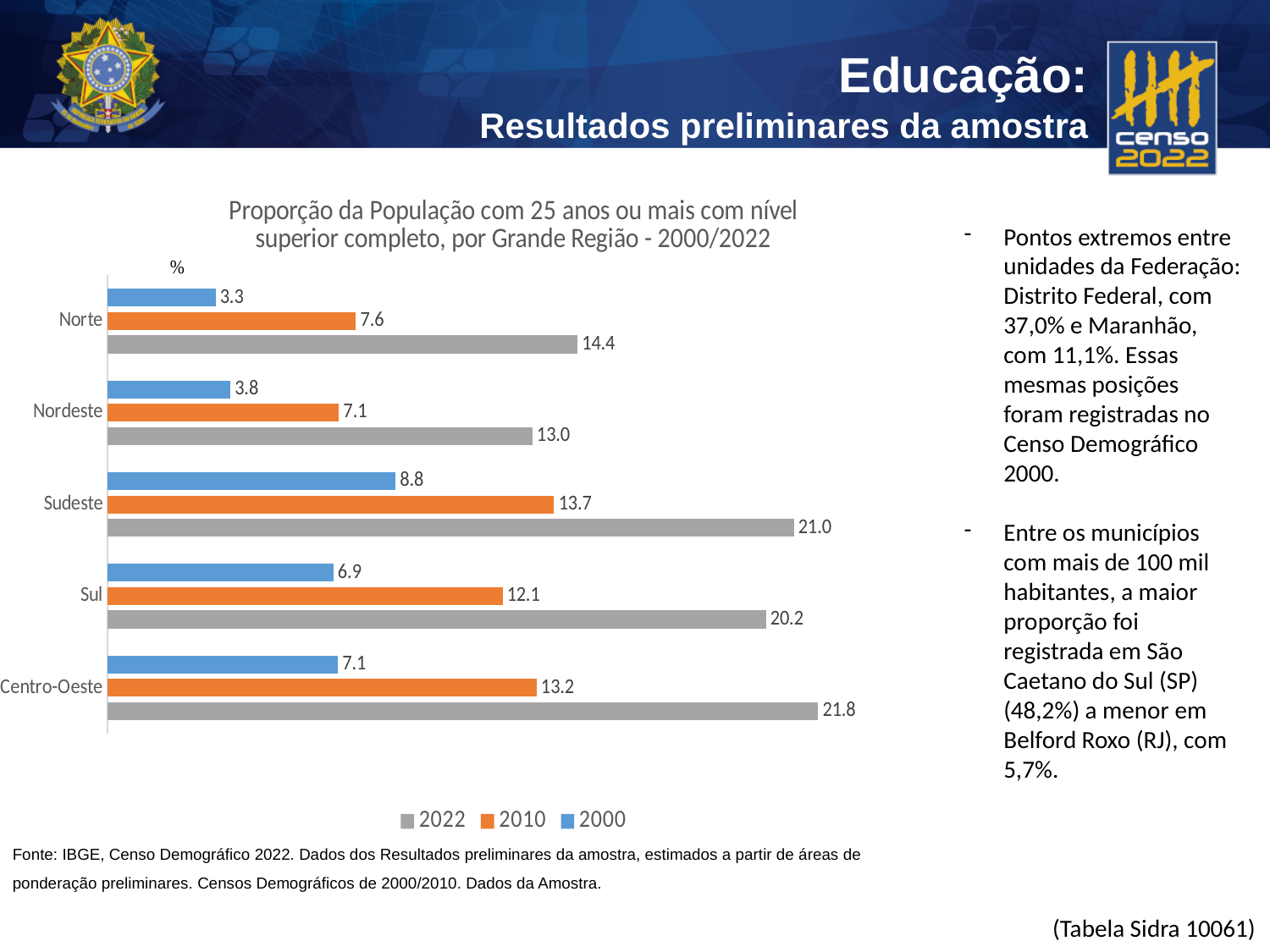
Which region has the lowest value in the 2000 series? Norte What is the difference between the 2022 values for Centro-Oeste and Sul? 1.6 How many regions are shown on the chart? 5 What is the difference between the 2022 and 2000 values for Nordeste? 9.2 What is the value for Norte in the 2000 series? 3.3 What is the value for Sul in the 2010 series? 12.1 Which region has the highest value in the 2022 series? Centro-Oeste Which is larger: the 2010 value for Sudeste or the 2010 value for Centro-Oeste? Sudeste What kind of chart is shown on the slide? Bar chart What is the value for Sudeste in the 2022 series? 21.0 Which series is shown in orange in the legend? 2010 How many series does the legend list? 3